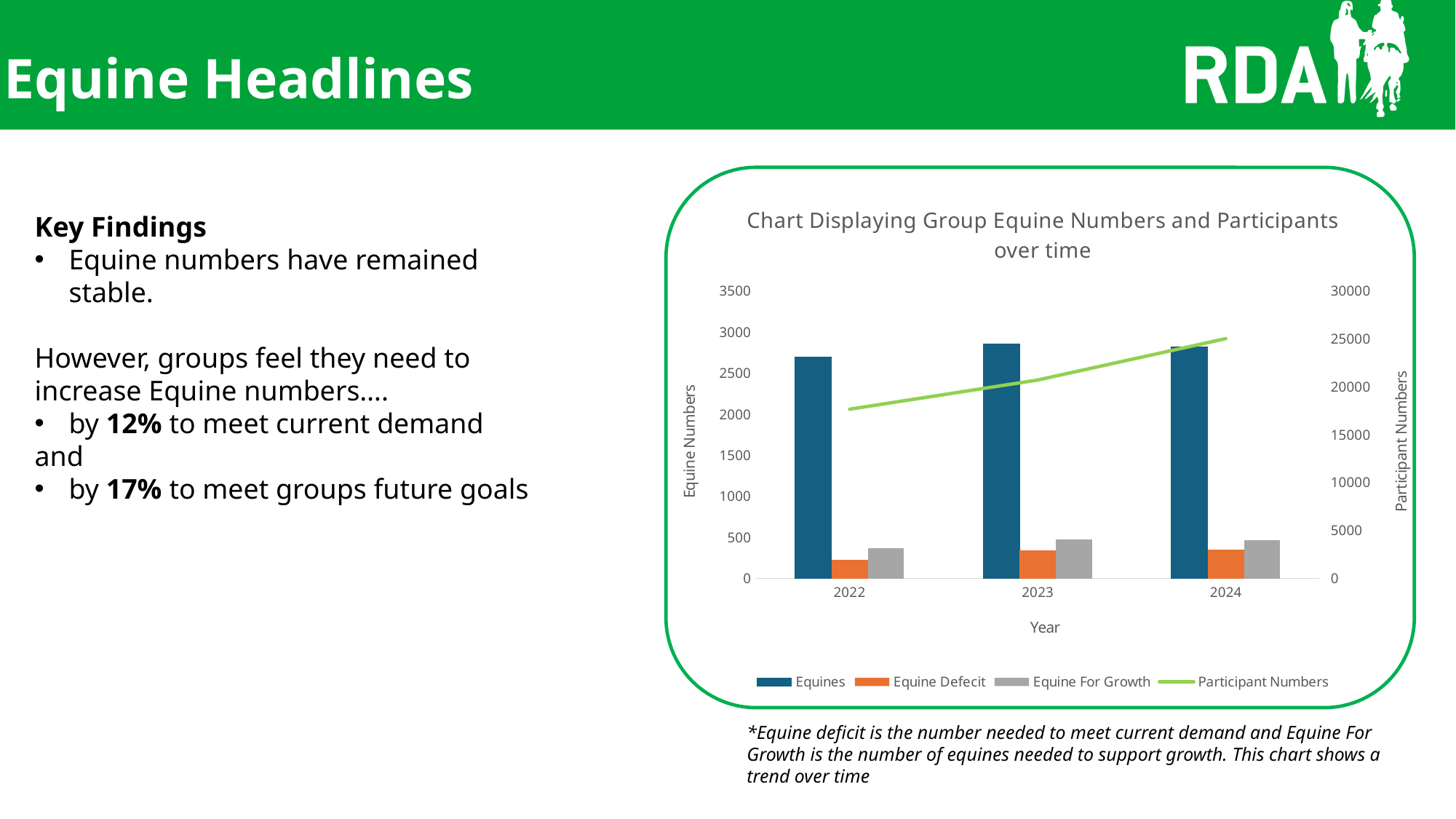
Is the value for Equine Defecit in 2022 greater or less than 500? less How many series does the chart legend list? 4 What kind of chart is shown on the slide? A combined bar and line chart Is the value for Equines in 2023 greater or less than 3000? less Is the value for Equines in 2022 greater or less than 2500? greater Do Participant Numbers rise or fall from 2022 to 2024? Rise In which year is the Equines bar lowest? 2022 What is the label on the right-hand vertical axis of the chart? Participant Numbers What is the title of the chart? Chart Displaying Group Equine Numbers and Participants over time In 2023, which is larger: Equine Defecit or Equine For Growth? Equine For Growth How many years are shown on the x axis of the chart? 3